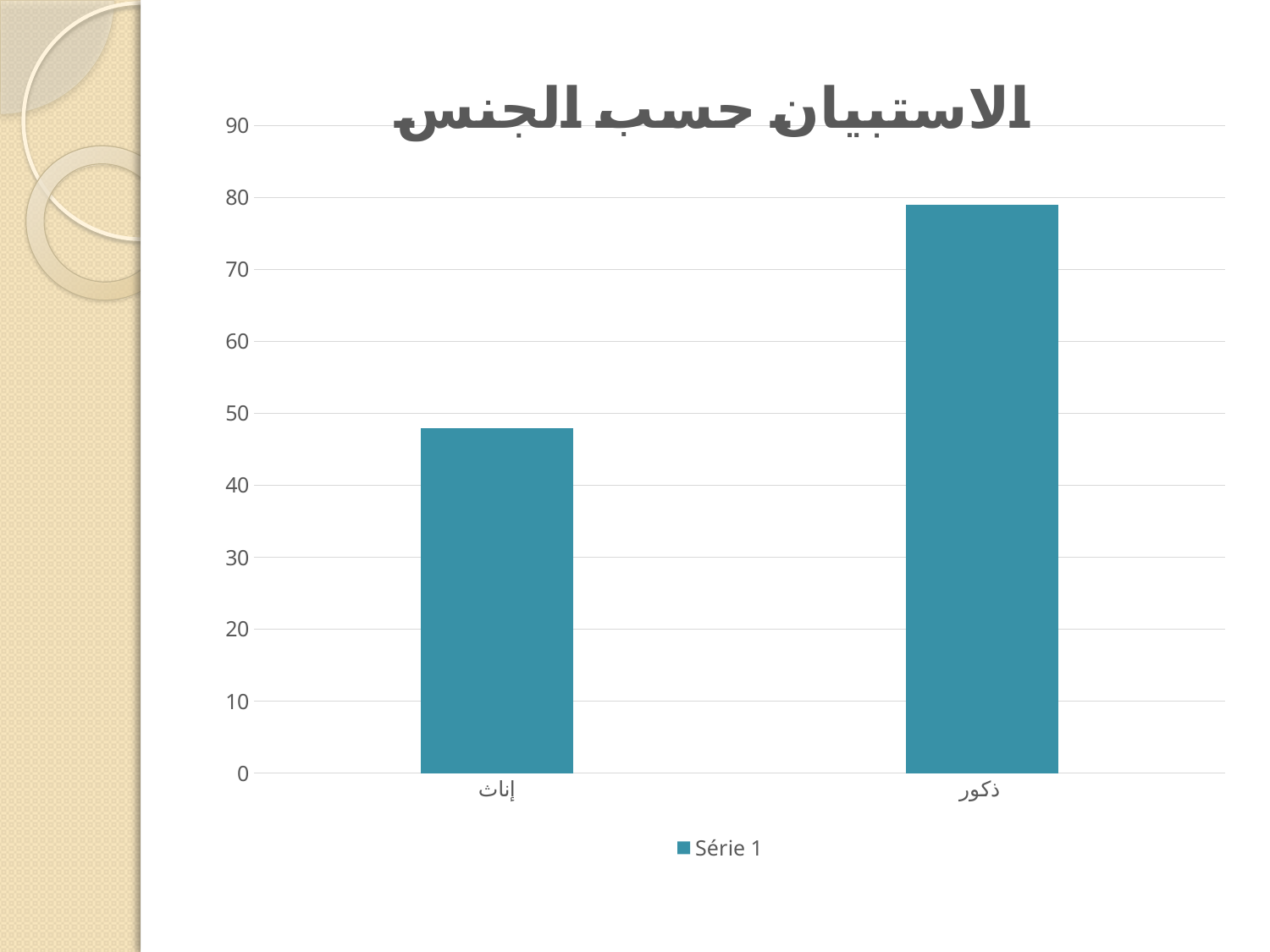
Which category has the highest bar in the chart? ذكور Is the value for ذكور greater or less than 70? greater How many series does the chart's legend list? 1 Is the value for إناث greater or less than 40? greater What is the name of the series shown in the chart's legend? Série 1 What is the title of the chart? الاستبيان حسب الجنس What kind of chart is shown on the slide? bar chart How many categories are shown on the x axis of the chart? 2 Which category has the lowest bar in the chart? إناث Is the value for إناث greater or less than 50? less Which is larger, the value for إناث or the value for ذكور? ذكور